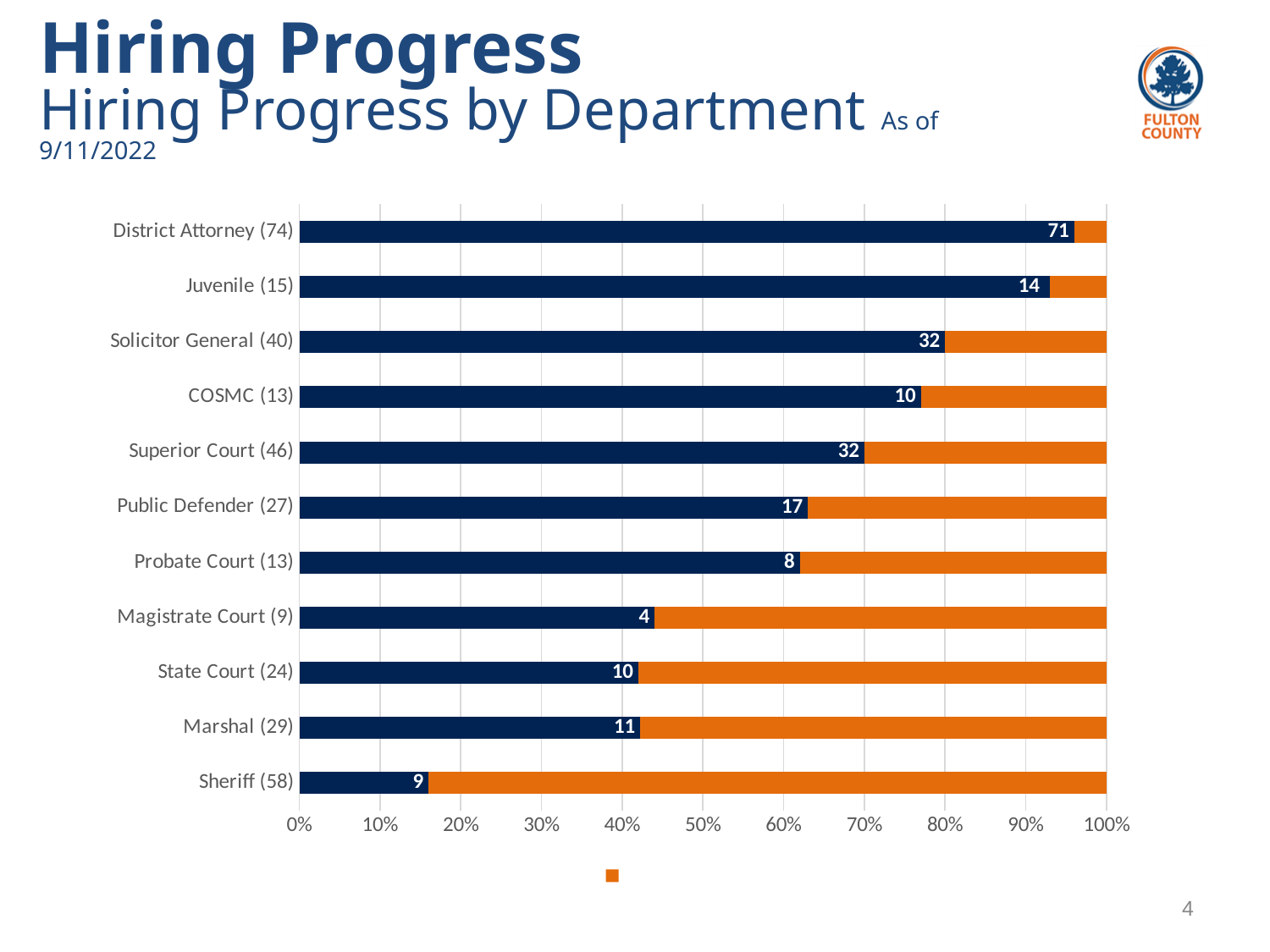
Which has the larger number printed on its dark blue bar, Marshal (29) or State Court (24)? Marshal (29) What kind of chart is shown on the slide? Stacked bar chart Is the dark blue bar for District Attorney (74) greater or less than 90% of the bar length? greater What is the difference between the numbers printed on the dark blue bars for Solicitor General (40) and COSMC (13)? 22 What number is printed on the dark blue bar for Magistrate Court (9)? 4 How many departments are shown on the chart? 11 Which department has the highest number printed on its dark blue bar? District Attorney (74) Is the dark blue bar for Sheriff (58) greater or less than 20% of the bar length? less What number is printed on the dark blue bar for Public Defender (27)? 17 What number is printed on the dark blue bar for District Attorney (74)? 71 Which department has the lowest number printed on its dark blue bar? Magistrate Court (9) What number is printed on the dark blue bar for Sheriff (58)? 9